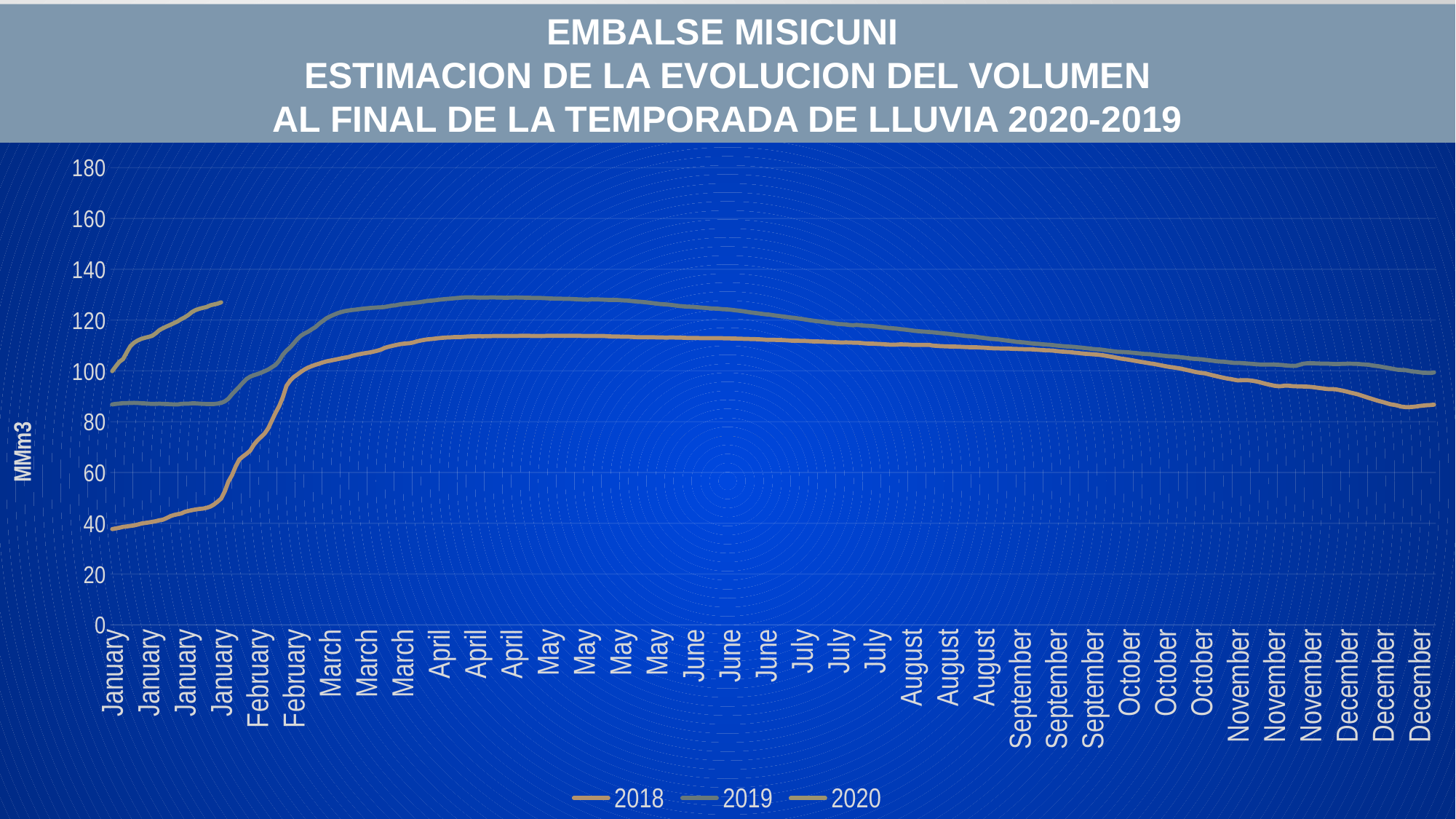
What kind of chart is shown on the slide? line chart Is the value for 2018 at the end of December greater or less than 100? less What is the label on the vertical axis? MMm3 Is the value for 2018 at the start of January greater or less than 60? less Does the 2019 series rise or fall from May to December? fall Which series are listed in the legend? 2018, 2019, 2020 Which series reaches the lowest value on the chart? 2018 Is the highest value reached by the 2019 series greater or less than 120? greater How many series does the legend list? 3 In April, which series has the larger value, 2018 or 2019? 2019